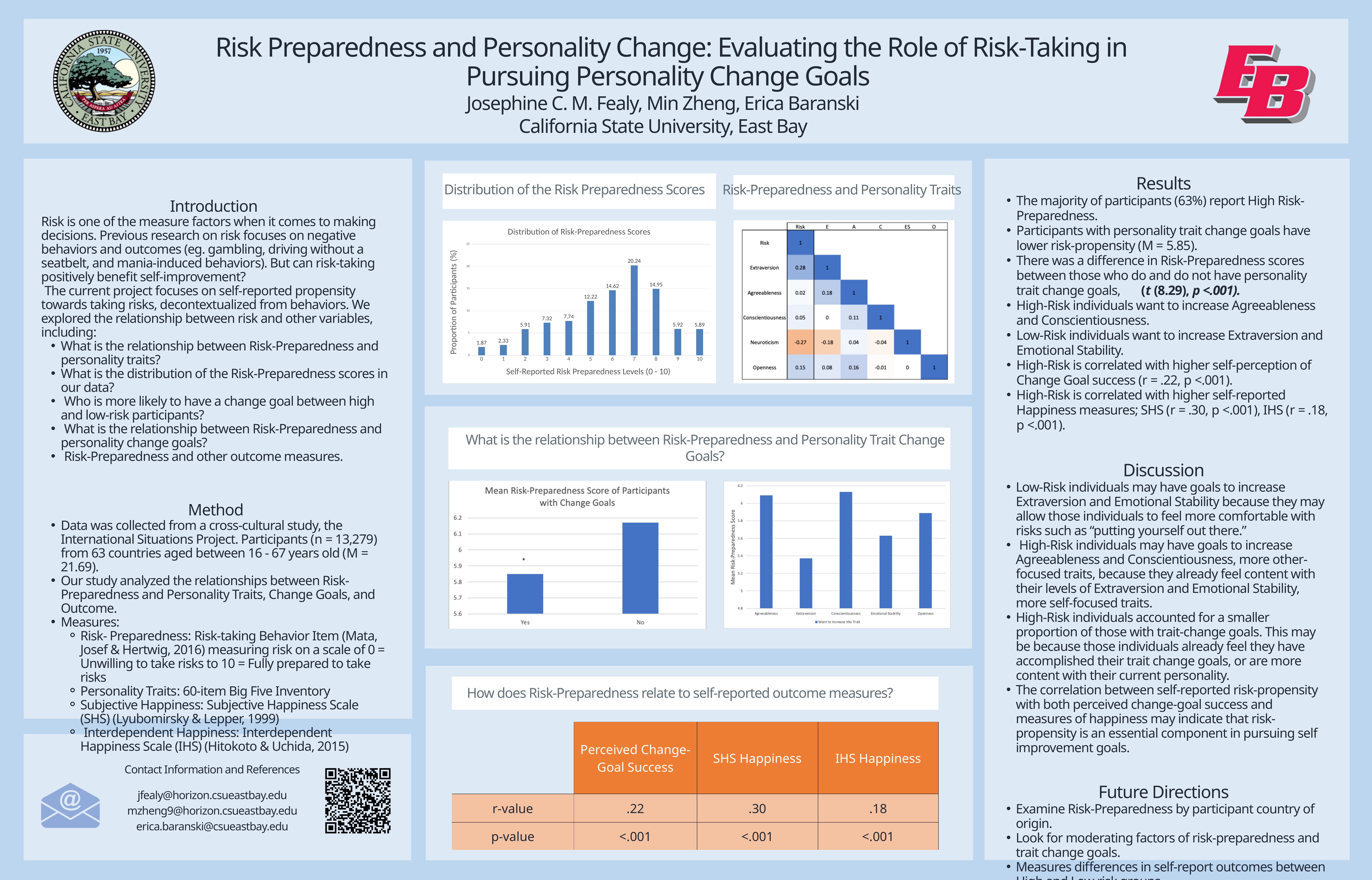
In the bar chart of mean risk-preparedness score by trait (bottom right of the middle column), what does the legend entry say? Want to increase this Trait In the bar chart of mean risk-preparedness score by trait (bottom right of the middle column), is the value for Openness greater or less than 5.8? greater In the 'Distribution of Risk-Preparedness Scores' chart, what proportion of participants reported a risk preparedness level of 7? 20.24 In the 'Mean Risk-Preparedness Score of Participants with Change Goals' chart, which group has the larger mean score, Yes or No? No In the 'Distribution of Risk-Preparedness Scores' chart, which risk preparedness level has the lowest proportion of participants? 0 In the 'Distribution of Risk-Preparedness Scores' chart, what is the proportion of participants at level 5? 12.22 What kind of chart is 'Mean Risk-Preparedness Score of Participants with Change Goals'? bar chart In the 'Distribution of Risk-Preparedness Scores' chart, how many risk preparedness levels are plotted on the x axis? 11 In the 'Distribution of Risk-Preparedness Scores' chart, which risk preparedness level has the highest proportion of participants? 7 In the 'Mean Risk-Preparedness Score of Participants with Change Goals' chart, is the value for Yes greater or less than 5.9? less In the bar chart of mean risk-preparedness score by trait (bottom right of the middle column), which trait has the lowest mean score? Extraversion In the 'Distribution of Risk-Preparedness Scores' chart, what is the difference between the proportions for levels 8 and 6? 0.33